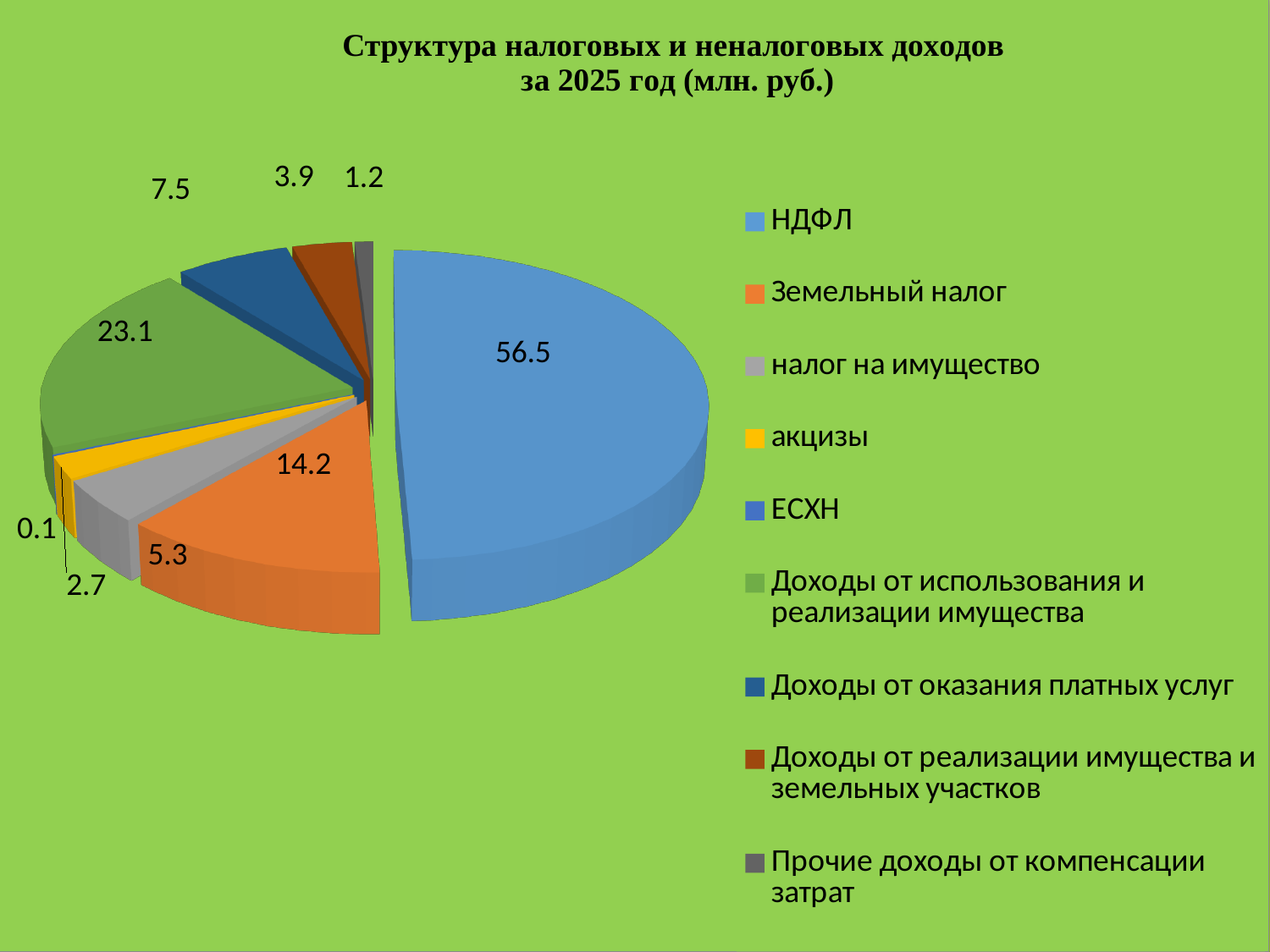
What is the value for НДФЛ? 56.5 What kind of chart is shown on the slide? Pie chart How many categories does the legend list? 9 What is the value for Земельный налог? 14.2 What is the title of the chart? Структура налоговых и неналоговых доходов за 2025 год (млн. руб.) What is the value for Доходы от оказания платных услуг? 7.5 Which category has the largest slice of the pie? НДФЛ What is the difference between the values for НДФЛ and Земельный налог? 42.3 Which is larger, Доходы от оказания платных услуг or Доходы от реализации имущества и земельных участков? Доходы от оказания платных услуг What is the value for налог на имущество? 5.3 What is the value for Доходы от использования и реализации имущества? 23.1 Which category has the smallest slice of the pie? ЕСХН